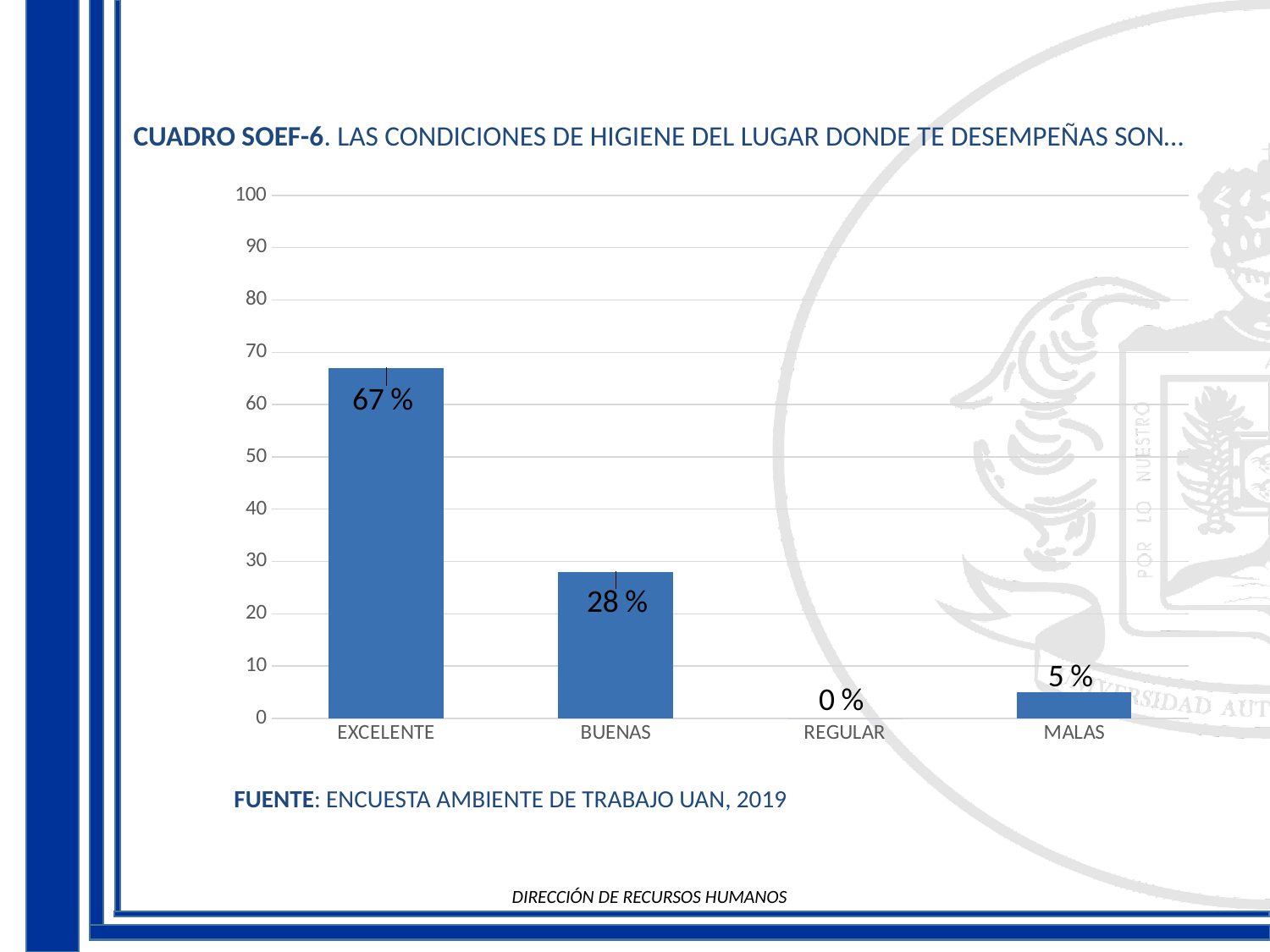
What is the value for EXCELENTE? 67 % What is the value for MALAS? 5 % What is the value for REGULAR? 0 % What is the difference between the values for EXCELENTE and BUENAS? 39 % Which category has the lowest value? REGULAR What is the value for BUENAS? 28 % How many categories are shown on the x axis? 4 Is the value for EXCELENTE greater or less than 60? greater What kind of chart is shown on the slide? bar chart What source is cited below the chart? ENCUESTA AMBIENTE DE TRABAJO UAN, 2019 Which category has the highest value? EXCELENTE Which is larger, the value for BUENAS or the value for MALAS? BUENAS